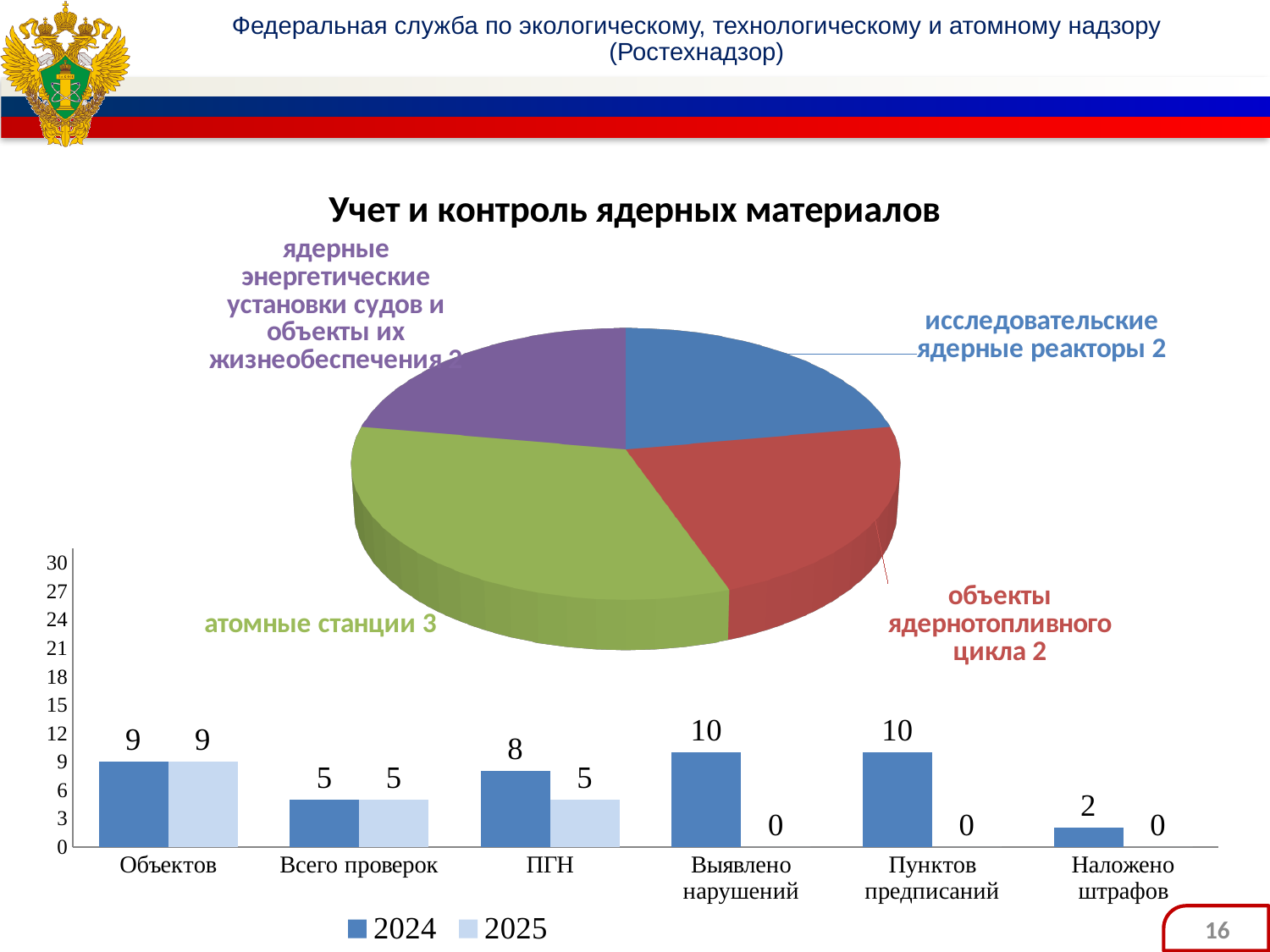
On the bar chart at the bottom of the slide, what is the difference between the 2024 and 2025 values for 'ПГН'? 3 On the bar chart at the bottom of the slide, what is the value for 'Выявлено нарушений' in 2025? 0 On the pie chart, how many slices are there? 4 On the pie chart, what is the value for 'атомные станции'? 3 On the bar chart at the bottom of the slide, how many series does the legend list? 2 On the bar chart at the bottom of the slide, which category has the lowest value for 2024? Наложено штрафов On the bar chart at the bottom of the slide, which is larger: the 2024 value for 'Пунктов предписаний' or the 2024 value for 'Объектов'? Пунктов предписаний On the bar chart at the bottom of the slide, what is the value for 'Наложено штрафов' in 2024? 2 On the bar chart at the bottom of the slide, how many categories are shown on the x axis? 6 On the bar chart at the bottom of the slide, what is the value for 'ПГН' in 2024? 8 On the pie chart, which category has the largest value? атомные станции What kind of chart is the chart at the bottom of the slide with the categories 'Объектов' and 'Всего проверок'? bar chart